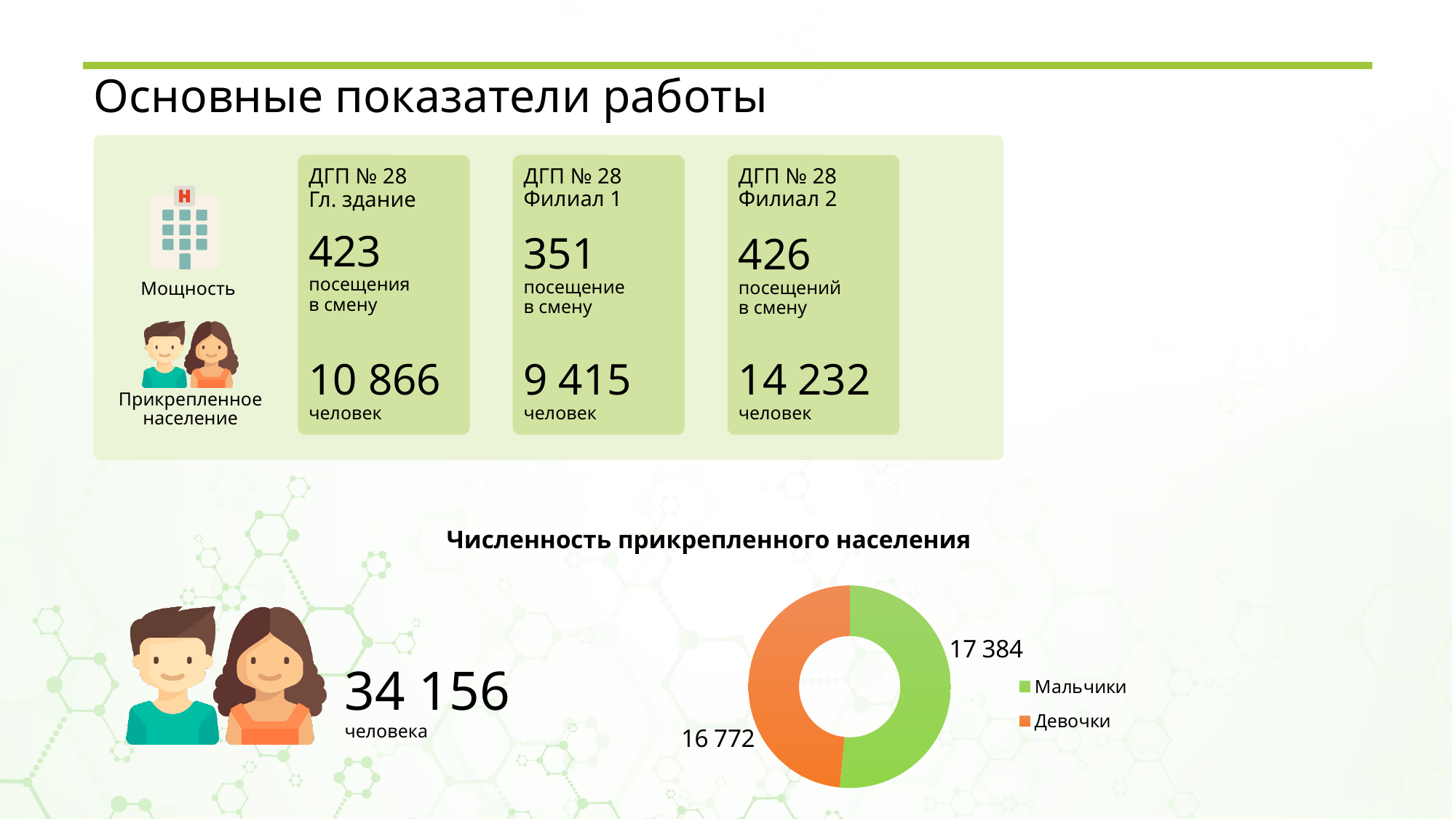
What is the title of the chart? Численность прикрепленного населения Which is larger, the value for Мальчики or the value for Девочки? Мальчики Which category has the smallest slice in the chart? Девочки What is the value for Девочки in the chart? 16 772 What is the value for Мальчики in the chart? 17 384 What is the total of the two values shown in the chart? 34 156 How many entries does the chart legend list? 2 How many categories does the chart show? 2 What is the difference between the values for Мальчики and Девочки? 612 Which category has the largest slice in the chart? Мальчики What colour represents Девочки in the chart? Orange What kind of chart is shown on the slide? Pie (doughnut) chart